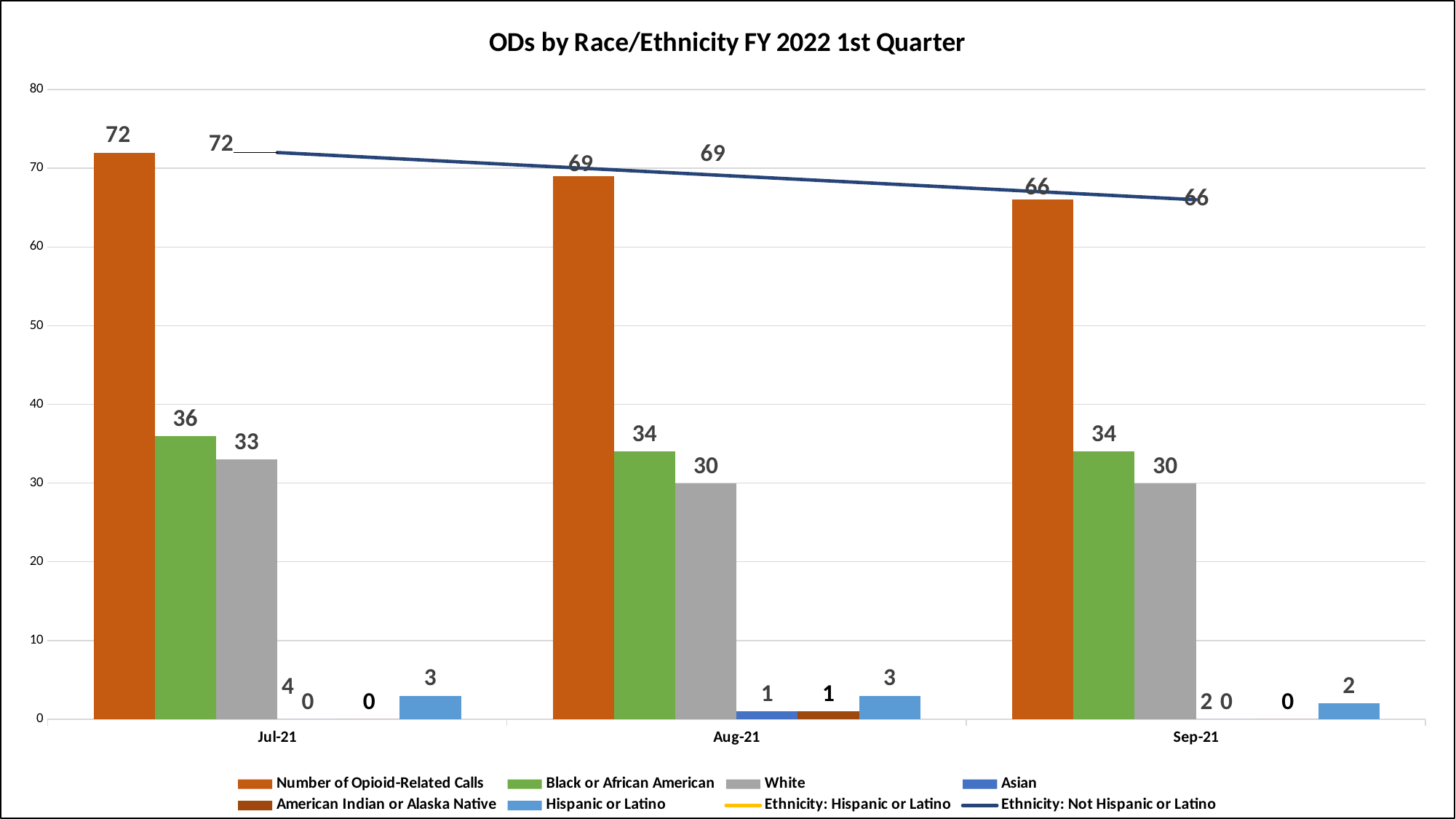
How many series does the legend list? 8 What is the value for White in Sep-21? 30 In Aug-21, which is larger: Black or African American or White? Black or African American By how much did the Number of Opioid-Related Calls fall from Jul-21 to Sep-21? 6 Which month has the highest Number of Opioid-Related Calls? Jul-21 How many months are shown on the x axis? 3 What is the difference between the Black or African American and White values in Jul-21? 3 What is the value for Hispanic or Latino in Sep-21? 2 Does the Ethnicity: Not Hispanic or Latino line rise or fall from Jul-21 to Sep-21? falls What is the Number of Opioid-Related Calls for Jul-21? 72 What is the value for Black or African American in Aug-21? 34 What is the value of the Ethnicity: Not Hispanic or Latino line for Aug-21? 69